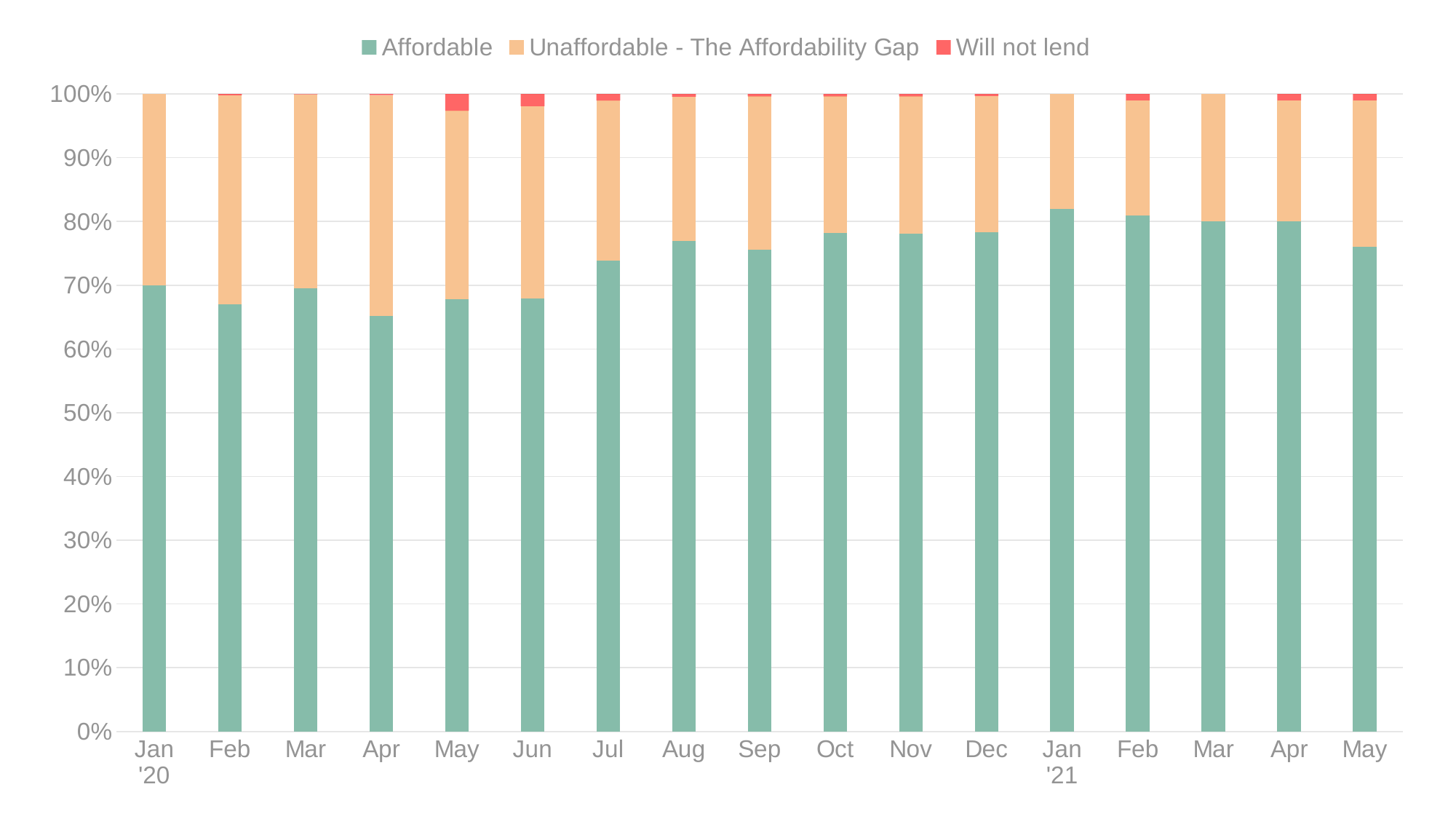
How many series does the legend list? 3 Is the Affordable value for Apr '20 greater or less than 70%? less Which has the larger Affordable share, Aug '20 or Apr '20? Aug '20 Which has the larger Affordable share, Jan '20 or Jan '21? Jan '21 Does the Affordable share generally rise or fall from Jan '20 to Jan '21? rise Which colour represents the 'Will not lend' series in the legend? Red What kind of chart is shown on the slide? Stacked bar chart Is the Affordable value for Jul '20 greater or less than 70%? greater Which month has the lowest Affordable share? Apr '20 Is the Affordable value for Jan '21 greater or less than 80%? greater How many months are plotted along the x axis? 17